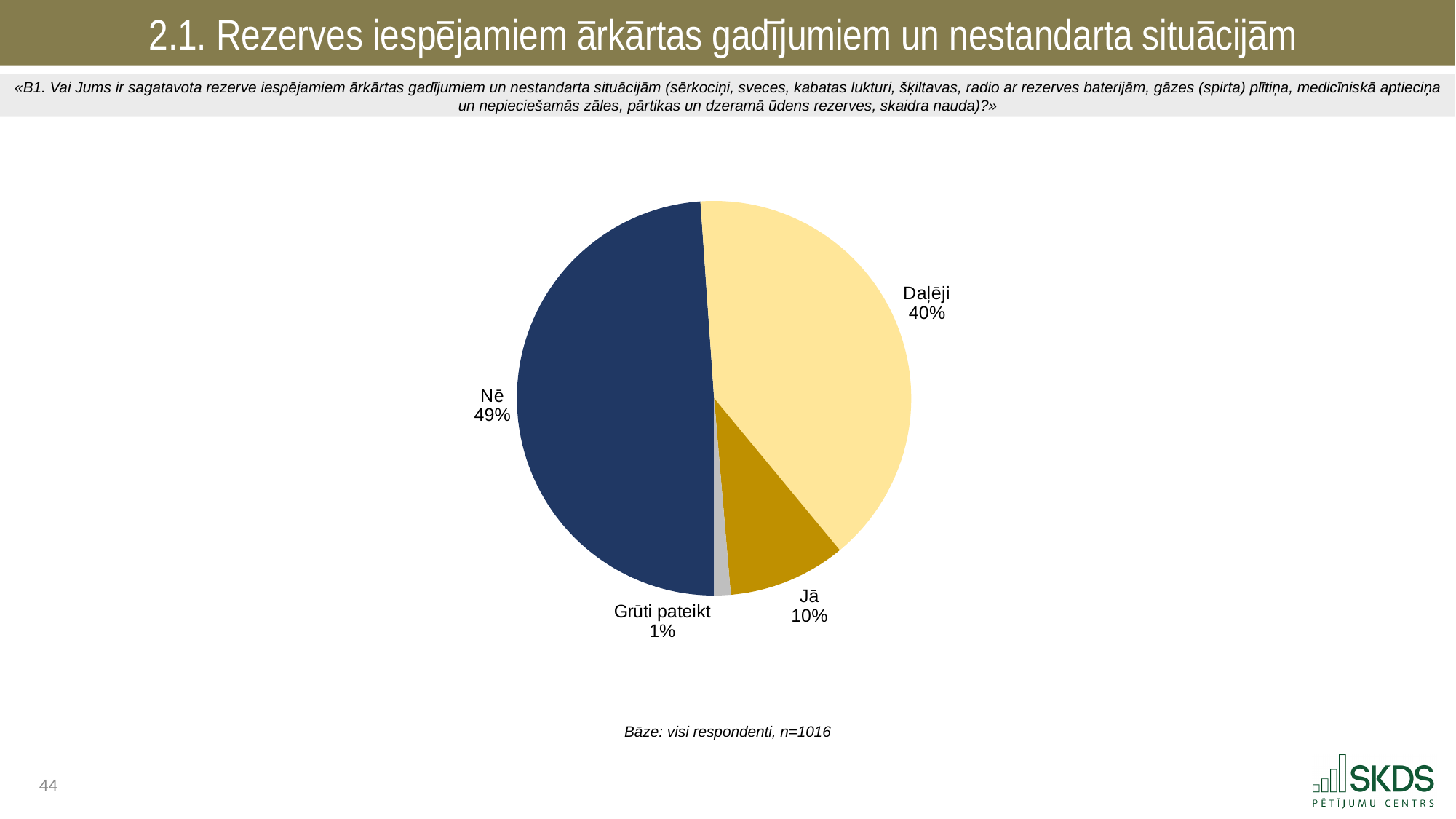
What share of respondents answered "Grūti pateikt"? 1% What is the difference in percentage points between "Nē" and "Daļēji"? 9 What share of respondents answered "Nē"? 49% Which is larger, the share for "Jā" or the share for "Daļēji"? Daļēji What is the difference in percentage points between "Daļēji" and "Jā"? 30 Which answer has the largest slice of the pie? Nē How many slices does the pie chart have? 4 What kind of chart is shown on the slide? pie chart Which answer has the smallest slice of the pie? Grūti pateikt What is the base (number of respondents) stated below the chart? n=1016 What share of respondents answered "Jā"? 10% What share of respondents answered "Daļēji"? 40%